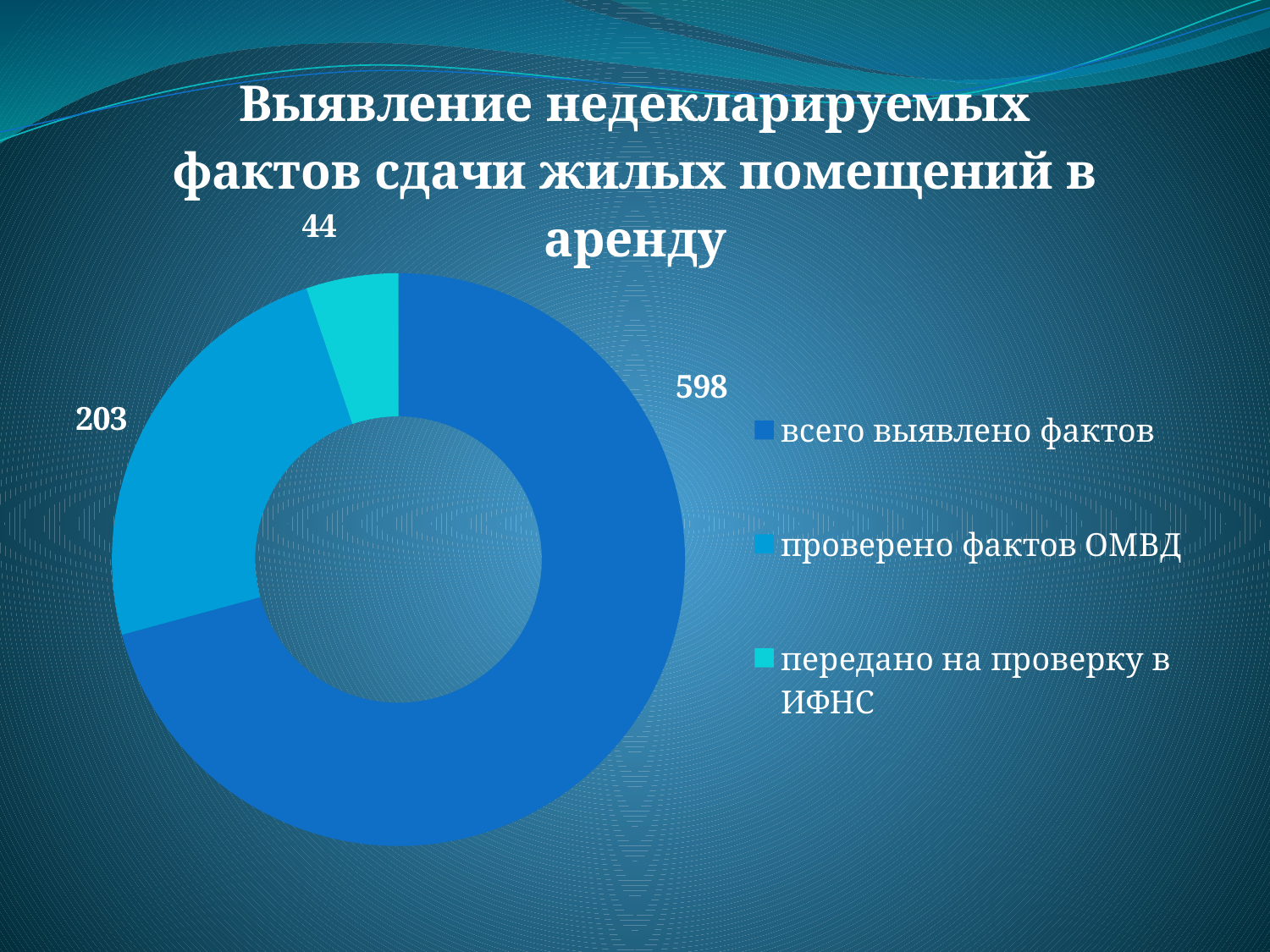
How many categories does the chart show? 3 Which category has the smallest value? передано на проверку в ИФНС What value is shown for "проверено фактов ОМВД"? 203 What is the difference between the values for "всего выявлено фактов" and "проверено фактов ОМВД"? 395 What value is shown for "всего выявлено фактов"? 598 What kind of chart is shown on the slide? Doughnut (pie) chart What is the difference between the values for "проверено фактов ОМВД" and "передано на проверку в ИФНС"? 159 What is the sum of all three values shown on the chart? 845 Which is larger: the value for "проверено фактов ОМВД" or the value for "передано на проверку в ИФНС"? проверено фактов ОМВД What value is shown for "передано на проверку в ИФНС"? 44 What is the title of the slide? Выявление недекларируемых фактов сдачи жилых помещений в аренду Which category has the largest value? всего выявлено фактов